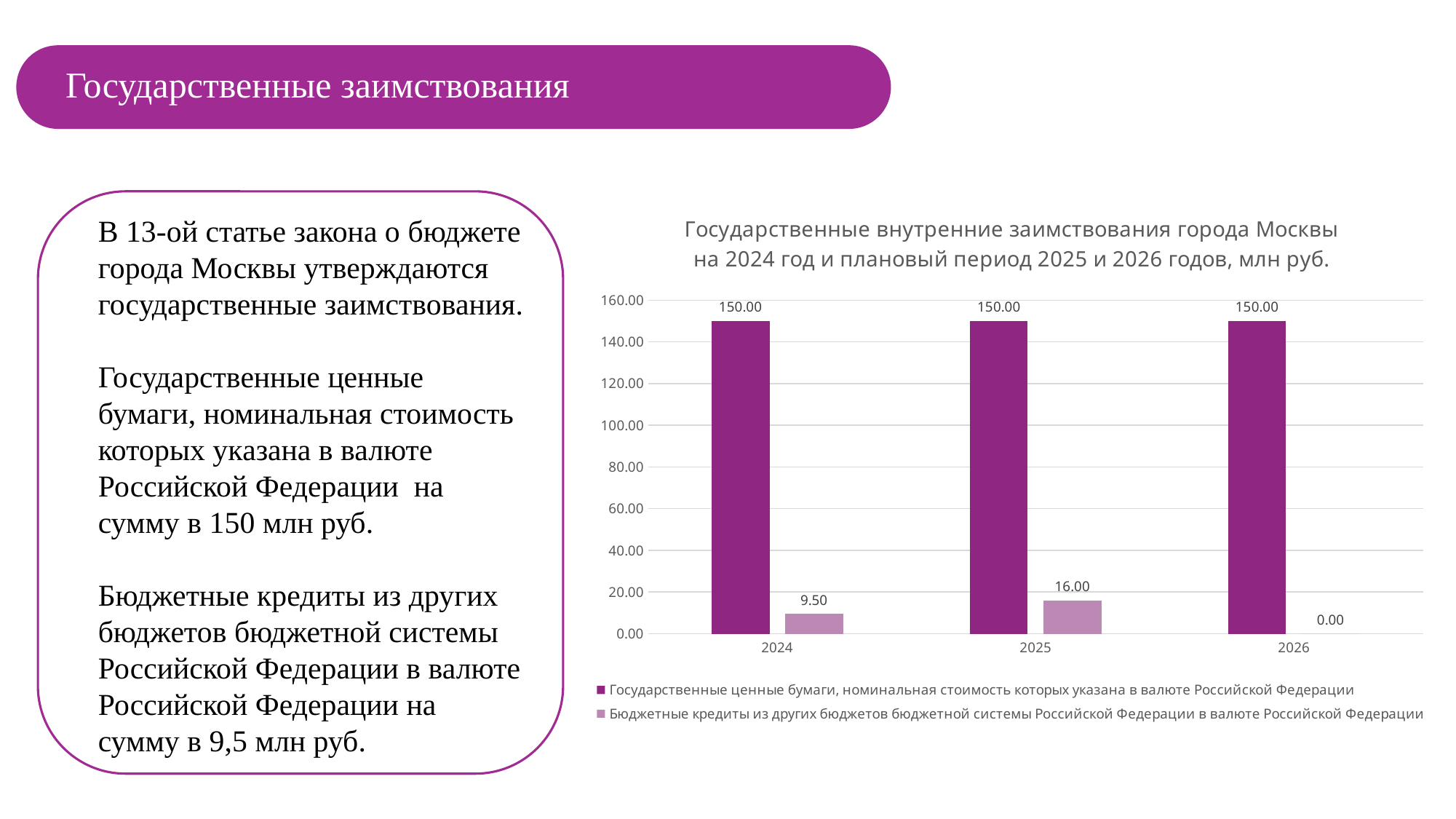
What is the value of 'Бюджетные кредиты из других бюджетов' for 2026? 0.00 What is the value of 'Государственные ценные бумаги' for 2024? 150.00 How many years are shown on the x axis? 3 In which year is the value for 'Бюджетные кредиты из других бюджетов' highest? 2025 What is the difference between 'Государственные ценные бумаги' and 'Бюджетные кредиты' in 2025? 134.00 In which year is the value for 'Бюджетные кредиты из других бюджетов' lowest? 2026 How many series does the legend list? 2 Which is larger in 2024: 'Государственные ценные бумаги' or 'Бюджетные кредиты из других бюджетов'? Государственные ценные бумаги What is the value of 'Бюджетные кредиты из других бюджетов' for 2024? 9.50 What is the value of 'Бюджетные кредиты из других бюджетов' for 2025? 16.00 What kind of chart is shown on the slide? Bar chart Does the value for 'Государственные ценные бумаги' rise, fall or stay the same from 2024 to 2026? Stays the same